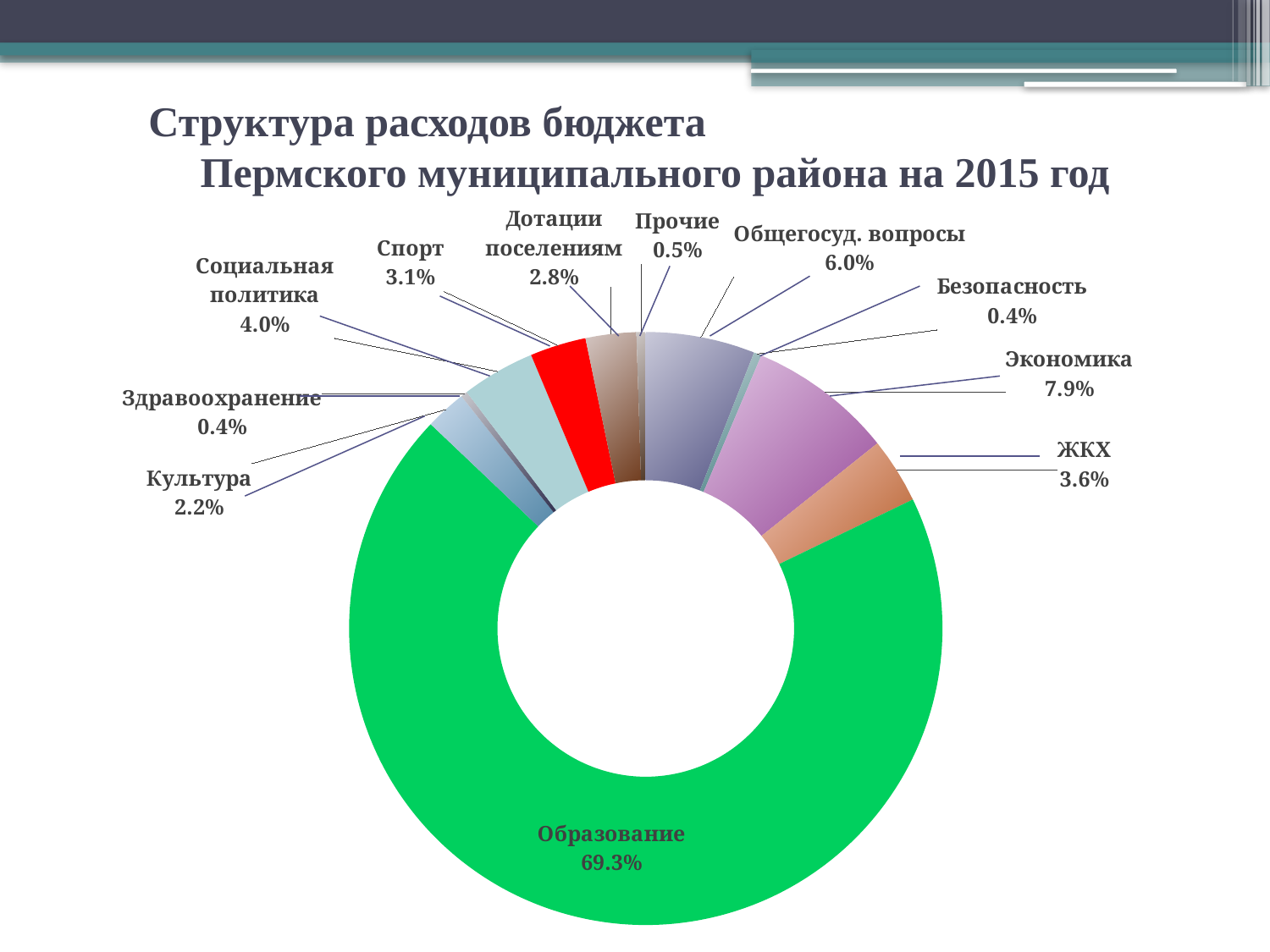
How many categories are shown in the chart? 11 What percentage is shown for Общегосуд. вопросы? 6.0% What is the difference between the shares for Образование and Экономика? 61.4% What is the difference between the shares for Экономика and Общегосуд. вопросы? 1.9% Which category has the largest share of the budget expenditure? Образование What share of the budget expenditure goes to Образование? 69.3% What share is shown for Дотации поселениям? 2.8% What is the value shown for Экономика? 7.9% Which is larger, the share for Спорт or the share for Социальная политика? Социальная политика What is the title of the slide? Структура расходов бюджета Пермского муниципального района на 2015 год What type of chart is shown on the slide? Doughnut (pie) chart What is the value for ЖКХ? 3.6%